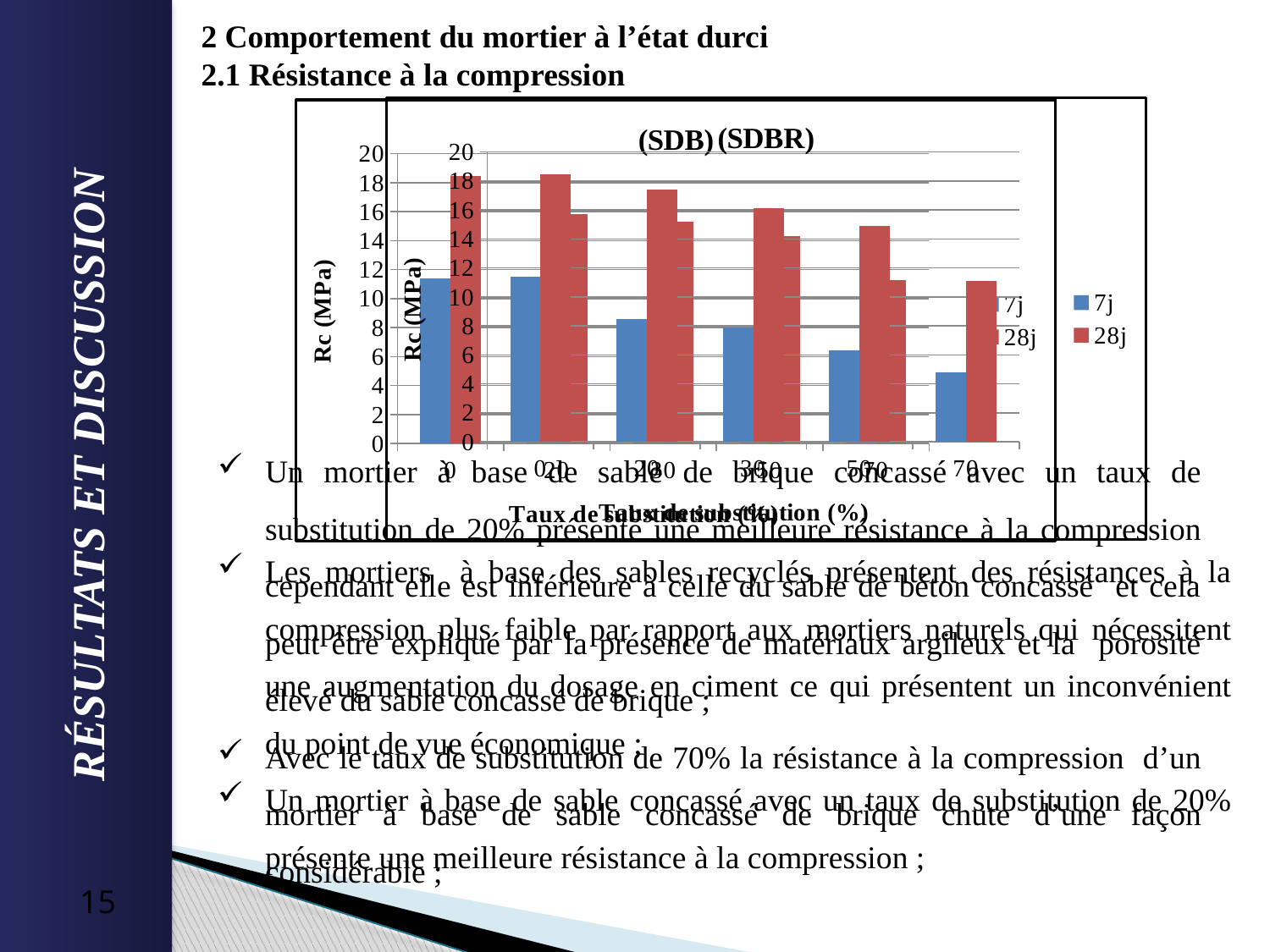
In the (SDBR) chart, do the 28j values rise or fall overall as the substitution rate increases from 0 to 70? fall In the (SDBR) chart, is the 7j value at a substitution rate of 0 greater or less than 10? greater In the (SDBR) chart, which series has the higher value at a substitution rate of 0, 7j or 28j? 28j How many substitution rates (categories) are shown on the x axis of the (SDBR) chart? 5 What is the y-axis title of the (SDBR) chart? Rc (MPa) In the (SDBR) chart, at which substitution rate is the 7j value lowest? 70 What kind of chart is shown on the slide? bar chart How many series does the legend of the (SDBR) chart list? 2 In the (SDBR) chart, do the 7j values rise or fall as the substitution rate increases from 0 to 70? fall What are the two series named in the legend of the (SDBR) chart? 7j and 28j In the (SDBR) chart, is the 28j value at a substitution rate of 0 greater or less than 16? greater